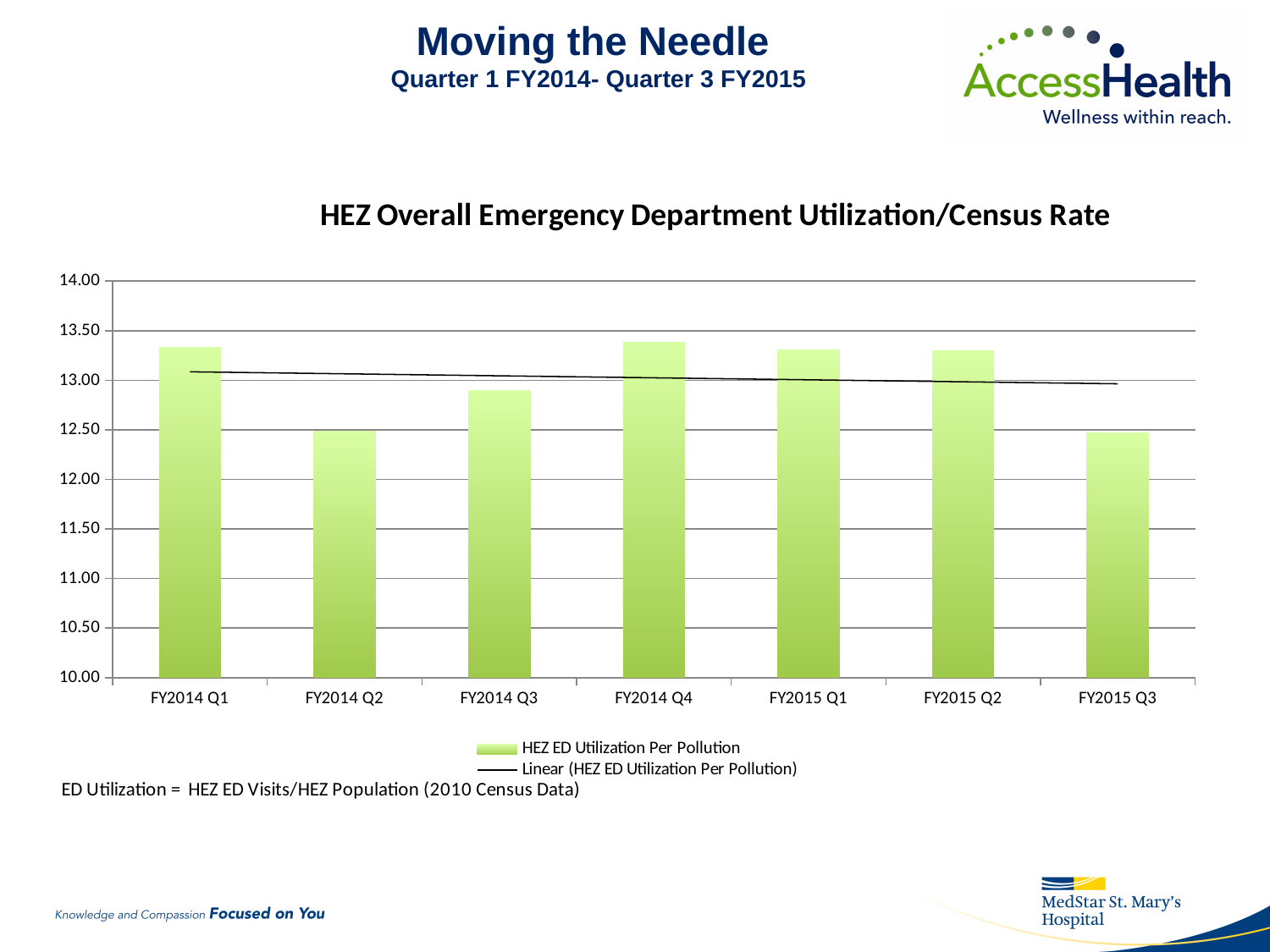
How many quarters are plotted on the x axis of the chart? 7 Is the value for FY2014 Q2 greater or less than 13.00? less How many entries does the chart's legend list? 2 What kind of chart is shown on the slide? bar chart Which is larger, the value for FY2015 Q2 or FY2015 Q3? FY2015 Q2 Which is larger, the value for FY2014 Q3 or FY2014 Q4? FY2014 Q4 Which is larger, the value for FY2014 Q1 or FY2014 Q2? FY2014 Q1 Is the value for FY2014 Q3 greater or less than 13.00? less Is the value for FY2015 Q1 greater or less than 13.00? greater What is the title of the chart? HEZ Overall Emergency Department Utilization/Census Rate What is the name of the bar series in the legend? HEZ ED Utilization Per Pollution